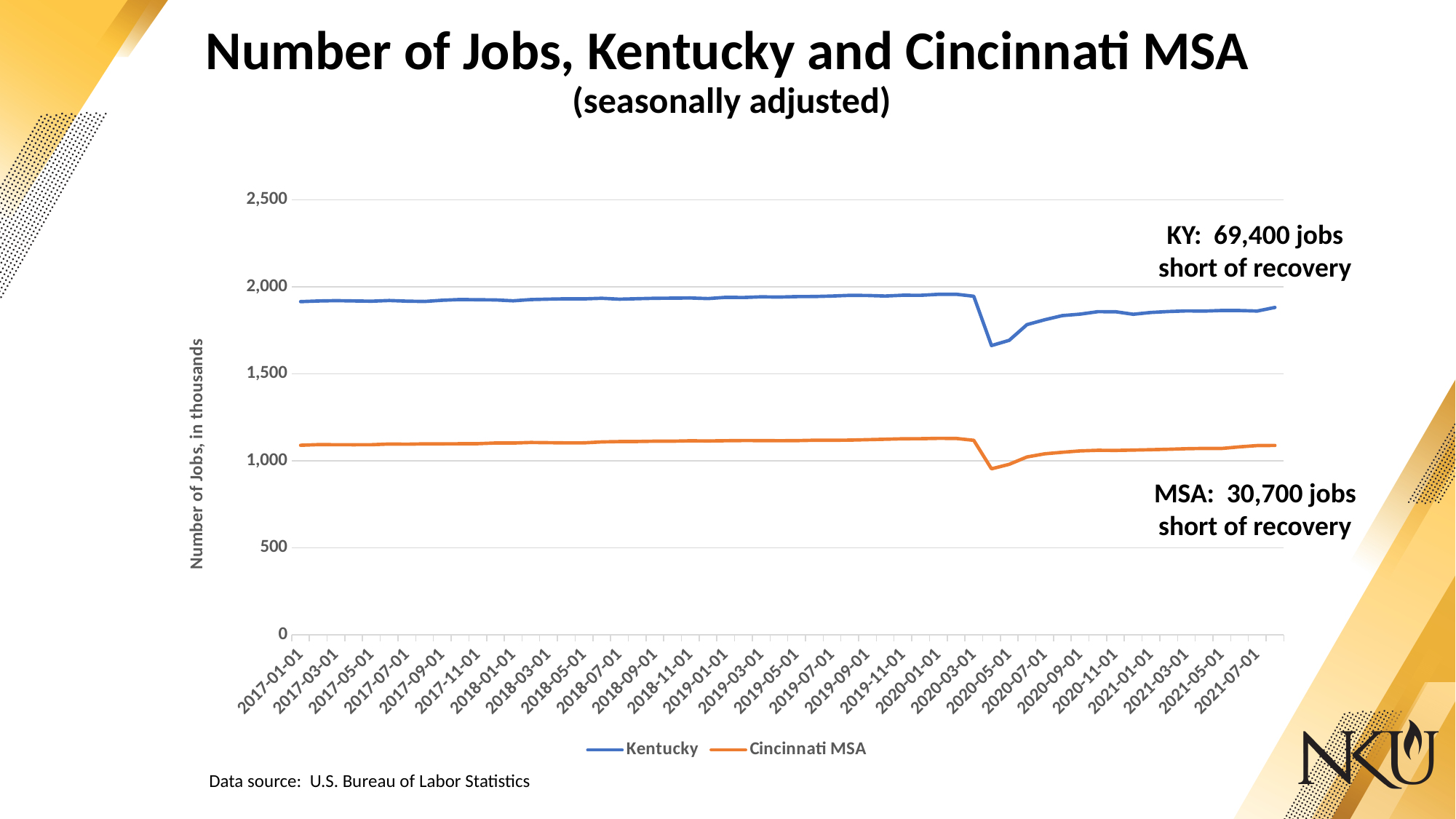
Which series has higher values throughout the chart, Kentucky or Cincinnati MSA? Kentucky Around which period do both lines show a sharp drop? Around 2020-03-01 to 2020-05-01 Is the value for Cincinnati MSA at 2021-07-01 greater or less than 1,000? greater Is the value for Kentucky at 2017-01-01 greater or less than 2,000? less According to the annotation, how many jobs short of recovery is the Cincinnati MSA? 30,700 jobs What kind of chart is shown on the slide? Line chart What is the label of the vertical axis? Number of Jobs, in thousands Is the value for Kentucky at 2020-05-01 greater or less than 1,500? greater How many series does the legend list? 2 According to the annotation, how many jobs short of recovery is Kentucky? 69,400 jobs What is the data source cited on the slide? U.S. Bureau of Labor Statistics